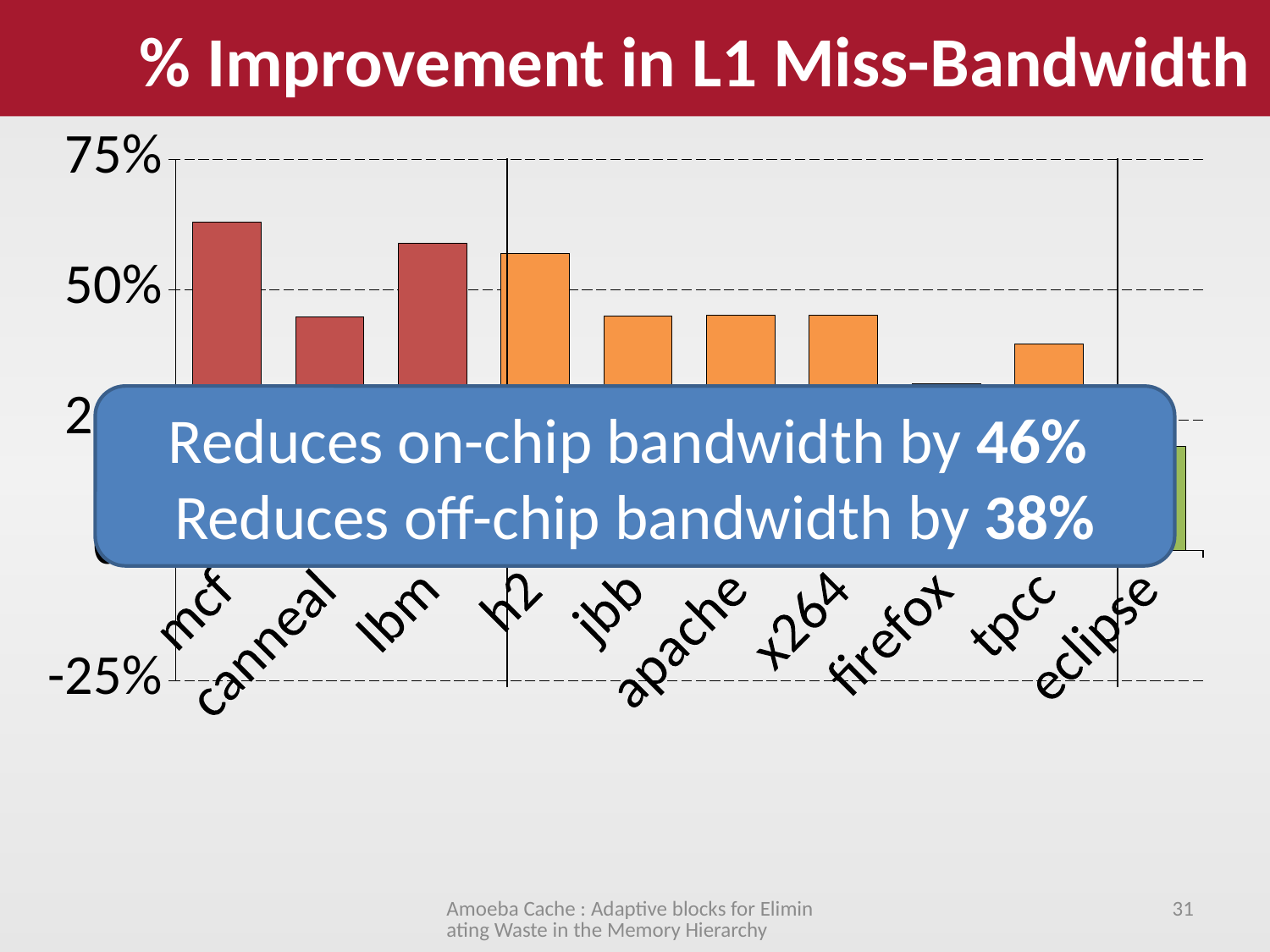
What is the title of the chart on the slide? % Improvement in L1 Miss-Bandwidth Is the value for jbb greater or less than 50%? less Which benchmark has the highest % improvement in L1 miss-bandwidth? mcf Is the value for tpcc greater or less than 50%? less Is the value for mcf greater or less than 50%? greater What kind of chart is shown on the slide? bar chart Which has a larger % improvement, lbm or tpcc? lbm Which has a larger % improvement, mcf or canneal? mcf How many categories (benchmarks) are shown on the x axis of the chart? 10